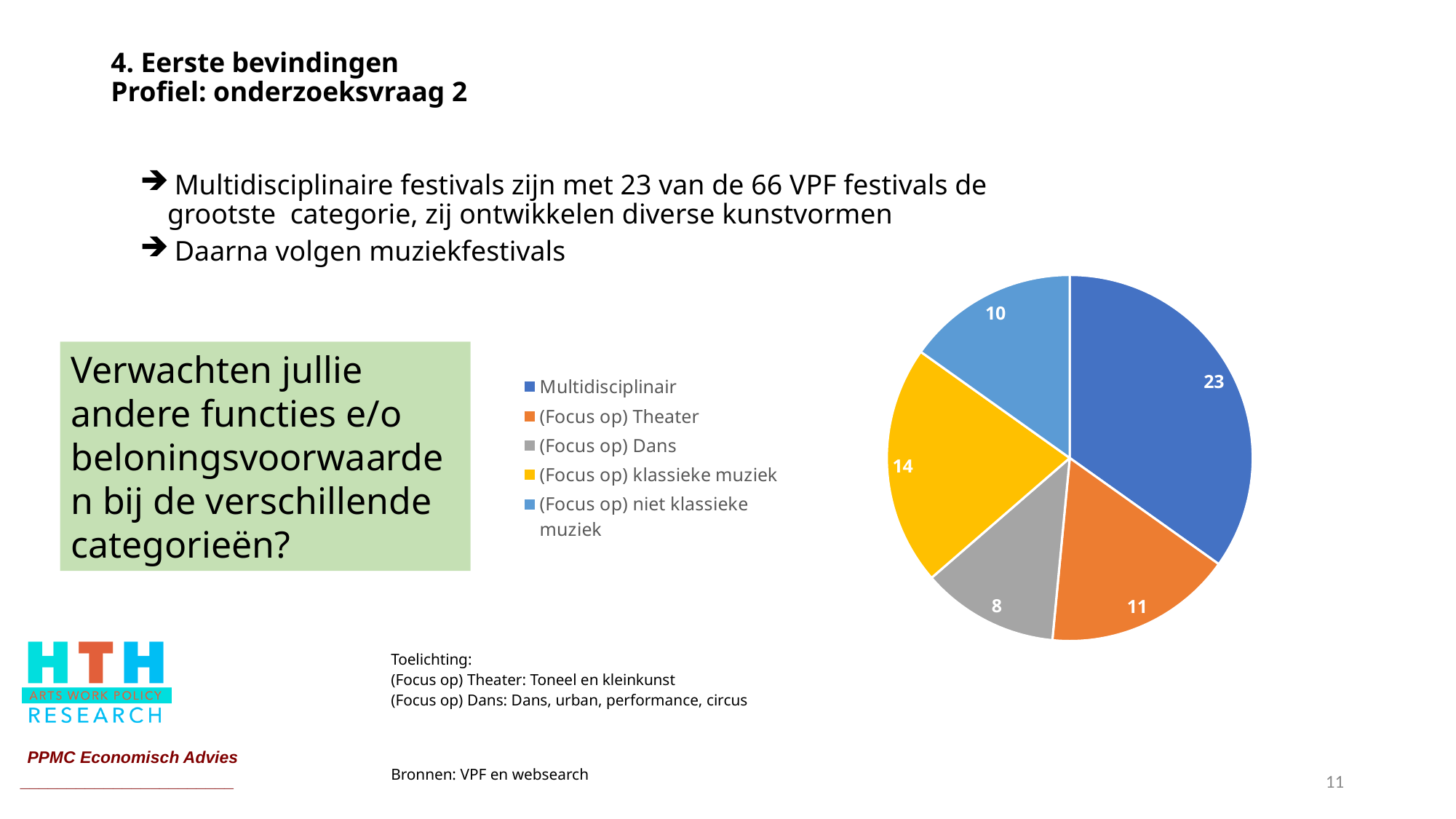
Which category has the smallest slice in the pie chart? (Focus op) Dans What is the difference between the values for Multidisciplinair and (Focus op) Theater? 12 Which is larger: (Focus op) klassieke muziek or (Focus op) niet klassieke muziek? (Focus op) klassieke muziek What type of chart is shown on the slide? pie chart What is the value for (Focus op) Dans in the pie chart? 8 What is the total of all slices in the pie chart? 66 What is the value for Multidisciplinair in the pie chart? 23 What is the value for (Focus op) Theater in the pie chart? 11 What is the value for (Focus op) klassieke muziek in the pie chart? 14 Which category has the largest slice in the pie chart? Multidisciplinair How many categories does the pie chart show? 5 What is the value for (Focus op) niet klassieke muziek in the pie chart? 10